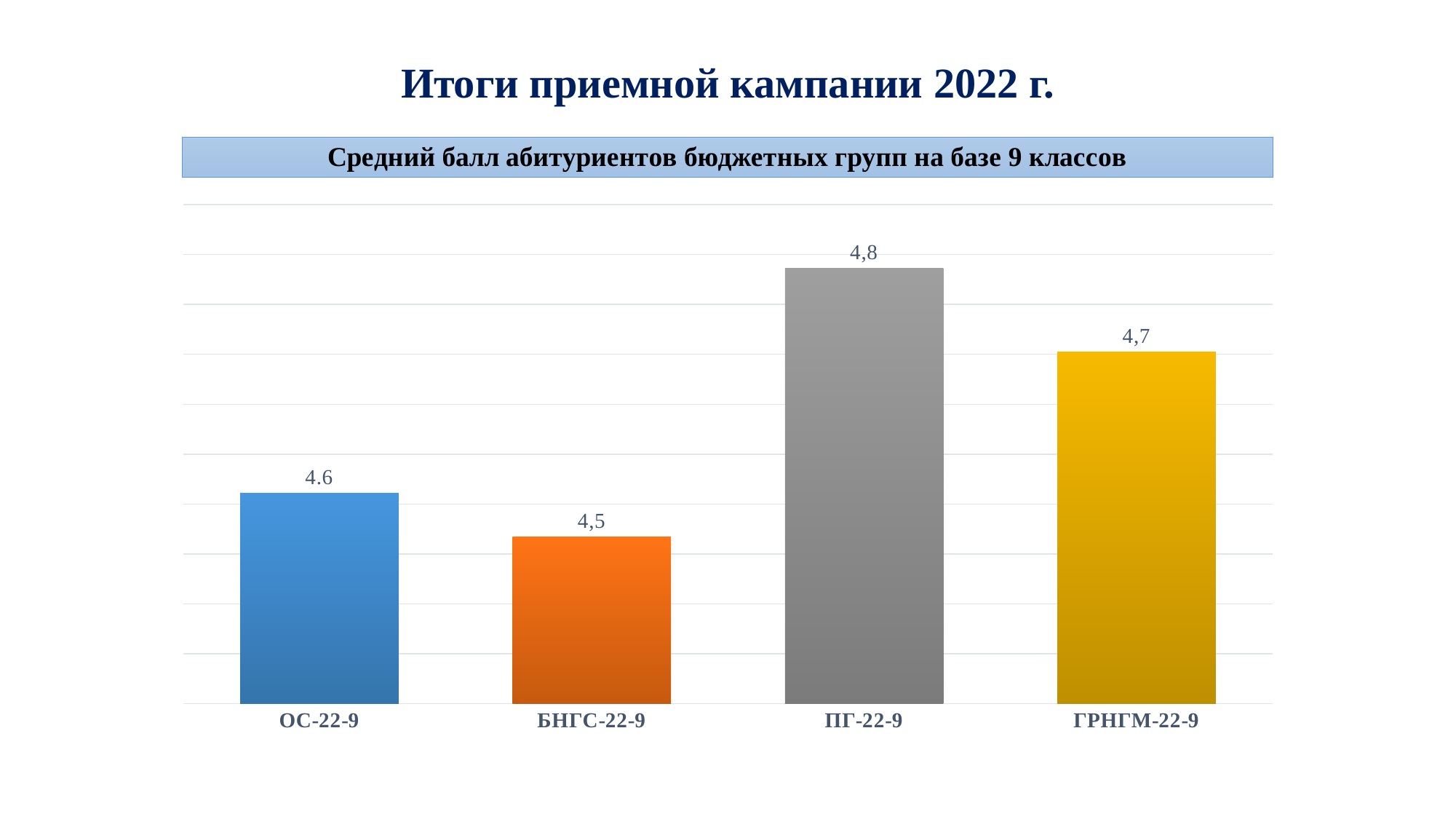
What is the average score shown for ОС-22-9? 4.6 What is the title of the chart? Средний балл абитуриентов бюджетных групп на базе 9 классов What type of chart is shown on the slide? Bar chart Which group has the highest average score? ПГ-22-9 What is the difference between the average scores of ПГ-22-9 and ГРНГМ-22-9? 0,1 Which group has a higher average score, ГРНГМ-22-9 or ОС-22-9? ГРНГМ-22-9 Which group has the lowest average score? БНГС-22-9 What is the average score shown for БНГС-22-9? 4,5 What is the average score shown for ПГ-22-9? 4,8 What is the difference between the average scores of ПГ-22-9 and БНГС-22-9? 0,3 How many groups are shown in the chart? 4 What is the average score shown for ГРНГМ-22-9? 4,7